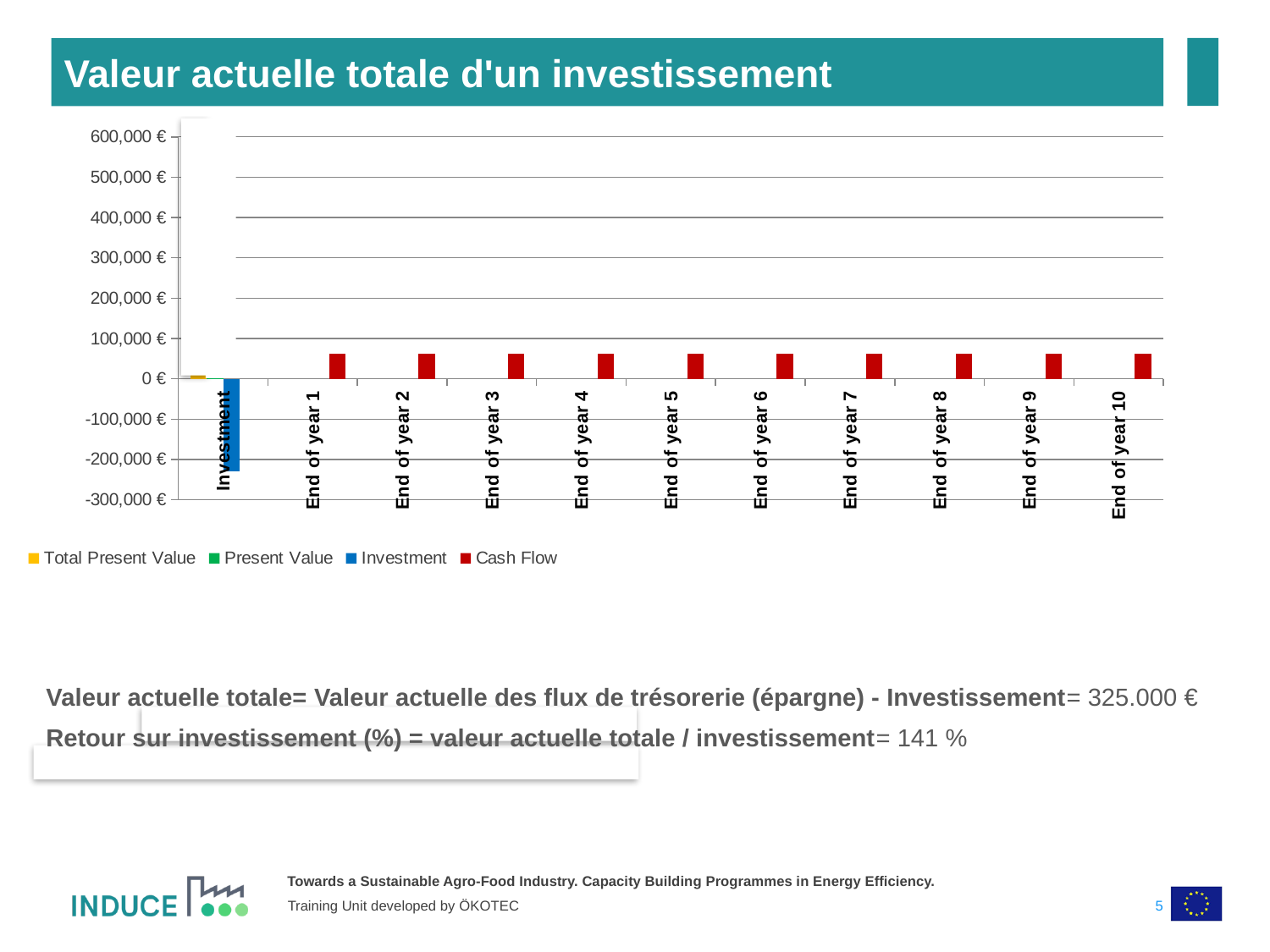
What is the highest value shown on the chart's y axis? 600,000 € What is the first series listed in the chart legend? Total Present Value Which category has the lowest value in the chart? Investment Do the Cash Flow values rise, fall or stay flat from End of year 1 to End of year 10? stay flat Is the Cash Flow value for End of year 5 greater or less than 0 €? greater Is the Cash Flow value for End of year 1 greater or less than 100,000 €? less How many series does the chart legend list? 4 What colour represents the Cash Flow series in the chart? red How many categories are shown on the x axis of the chart? 11 What kind of chart is shown on the slide? bar chart Is the value of the Investment bar greater or less than -200,000 €? less Which is larger, the Cash Flow value for End of year 3 or the Investment value? Cash Flow for End of year 3